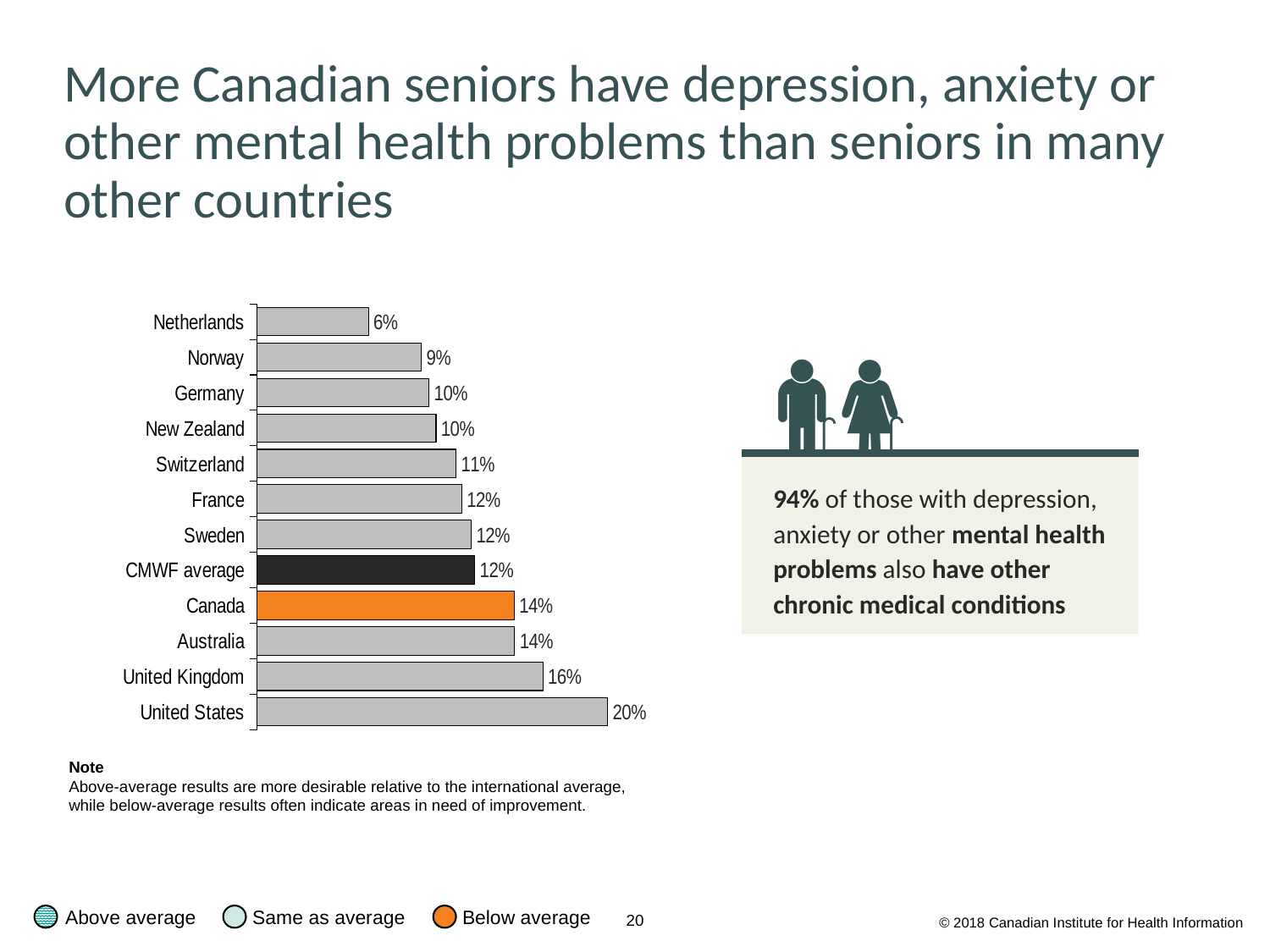
What is the value for the Netherlands? 6% What is the value for the CMWF average? 12% What kind of chart is shown on the slide? Bar chart Which category has the lowest value? Netherlands What is the difference between the values for Canada and the CMWF average? 2% Which category has the highest value? United States Which is larger, the value for Norway or the value for Switzerland? Switzerland How many categories are shown in the chart? 12 What is the value for the United Kingdom? 16% What colour is the bar for Canada? Orange What is the difference between the values for the United States and Canada? 6% What is the value for Canada? 14%